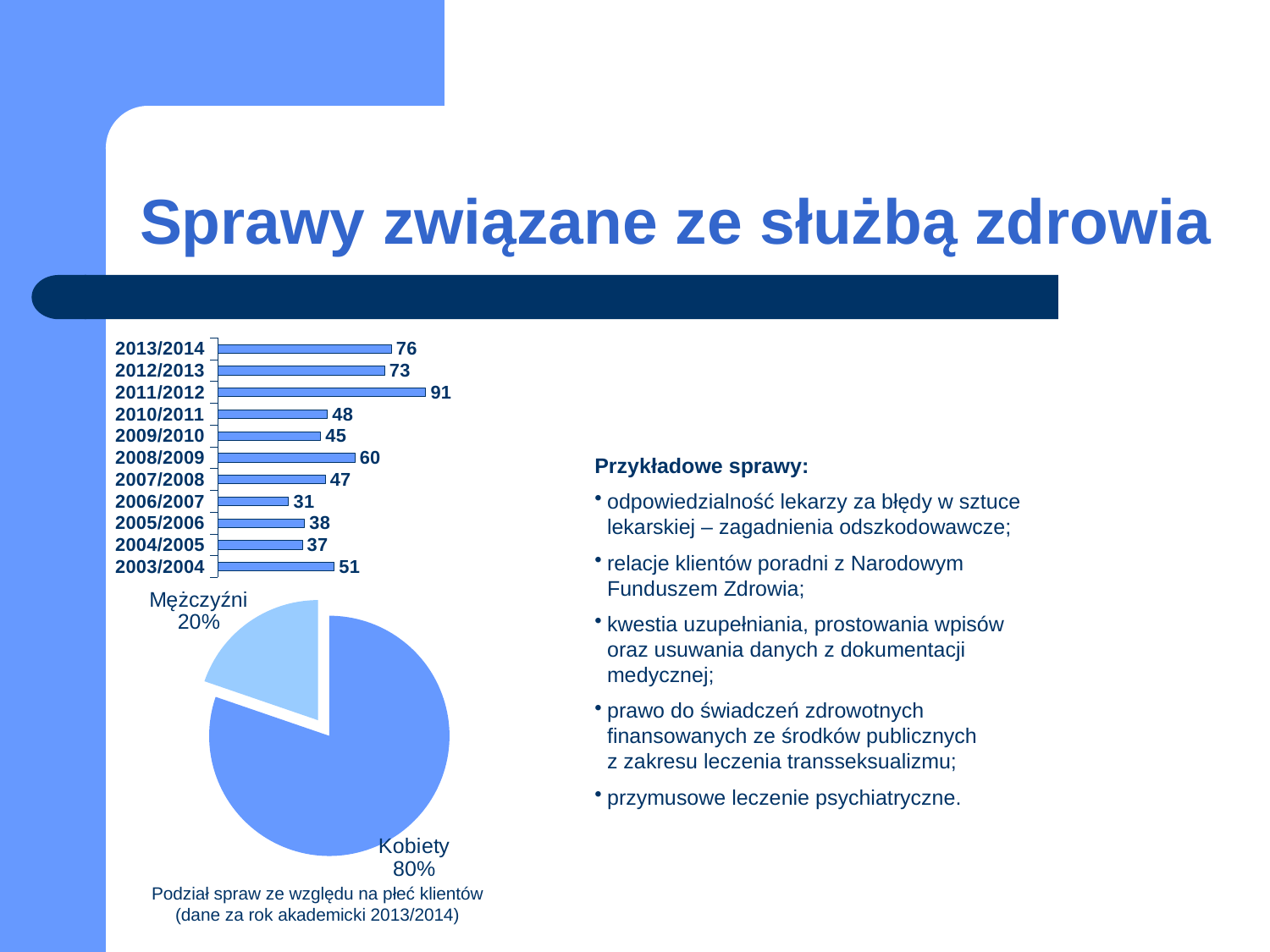
In the bar chart, which academic year has the lowest value? 2006/2007 In the bar chart, what is the difference between the values for 2013/2014 and 2012/2013? 3 What type of chart is the lower chart on the slide? pie chart In the bar chart, what is the value for 2003/2004? 51 In the bar chart, which academic year has the highest value? 2011/2012 In the bar chart, which is larger, the value for 2008/2009 or the value for 2007/2008? 2008/2009 In the pie chart, what share is labelled Kobiety? 80% What type of chart is the upper chart on the slide? bar chart In the pie chart, what share is labelled Mężczyźni? 20% In the bar chart, what is the difference between the values for 2011/2012 and 2006/2007? 60 How many academic years are shown in the bar chart? 11 In the bar chart, what is the value for 2011/2012? 91